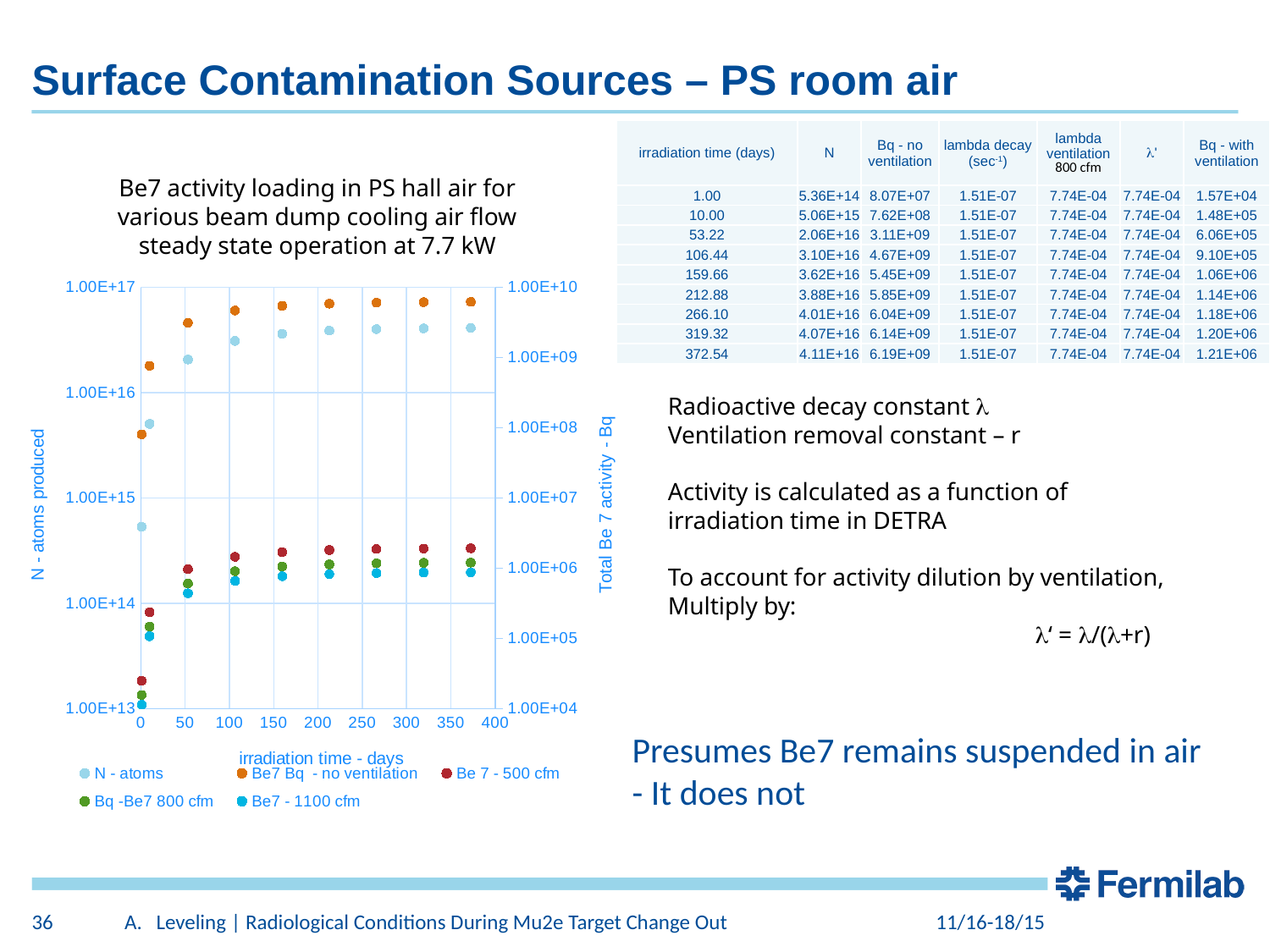
What is the label of the x axis of the chart? irradiation time - days Is the Be7 Bq - no ventilation value at about 372 days greater or less than 1.00E+09 on the right axis? greater Does the N - atoms series rise or fall as irradiation time increases? rise How many data points are plotted for the N - atoms series? 9 What kind of chart is shown on the slide? scatter chart Among the ventilated Be7 series, which has the lowest activity at about 372 days? Be7 - 1100 cfm Is the N - atoms value at about 372 days greater or less than 1.00E+16? greater At about 372 days, which is larger: Be7 Bq - no ventilation or Be7 - 1100 cfm? Be7 Bq - no ventilation Which Be7 activity series has the highest values across the chart? Be7 Bq - no ventilation How many series does the chart legend list? 5 What is the label of the right-hand y axis of the chart? Total Be 7 activity - Bq